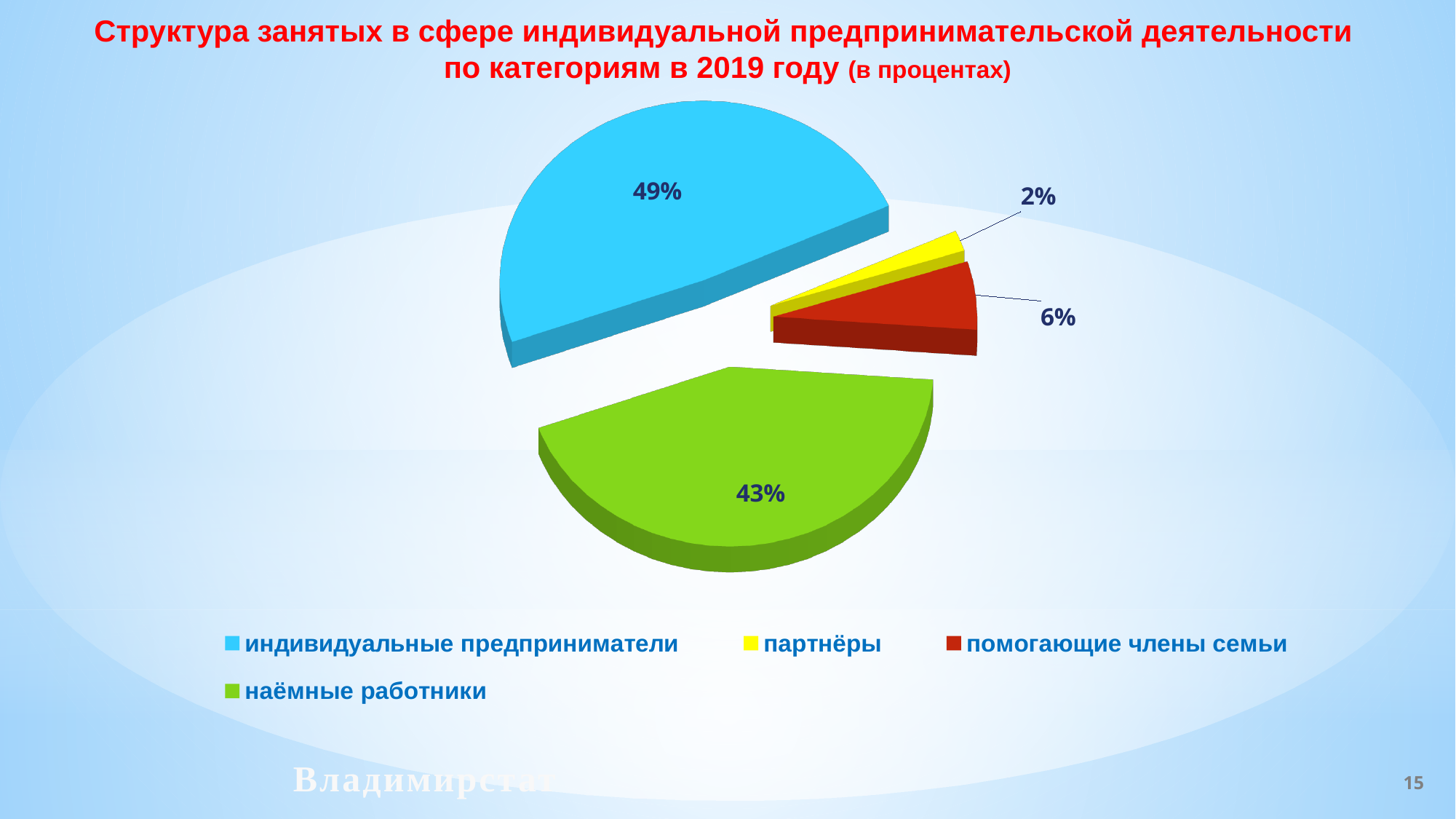
Which year does the chart title refer to? 2019 Which category has the largest share of the pie? индивидуальные предприниматели Which category has the smallest share of the pie? партнёры What share of the pie is labelled for помогающие члены семьи? 6% What is the difference in percentage points between индивидуальные предприниматели and наёмные работники? 6 What colour is the slice for наёмные работники? green What share of the pie is labelled for партнёры? 2% What share of the pie is labelled for индивидуальные предприниматели? 49% What share of the pie is labelled for наёмные работники? 43% Which is larger: the share for помогающие члены семьи or the share for партнёры? помогающие члены семьи What kind of chart is shown on the slide? pie chart How many categories does the pie chart show? 4